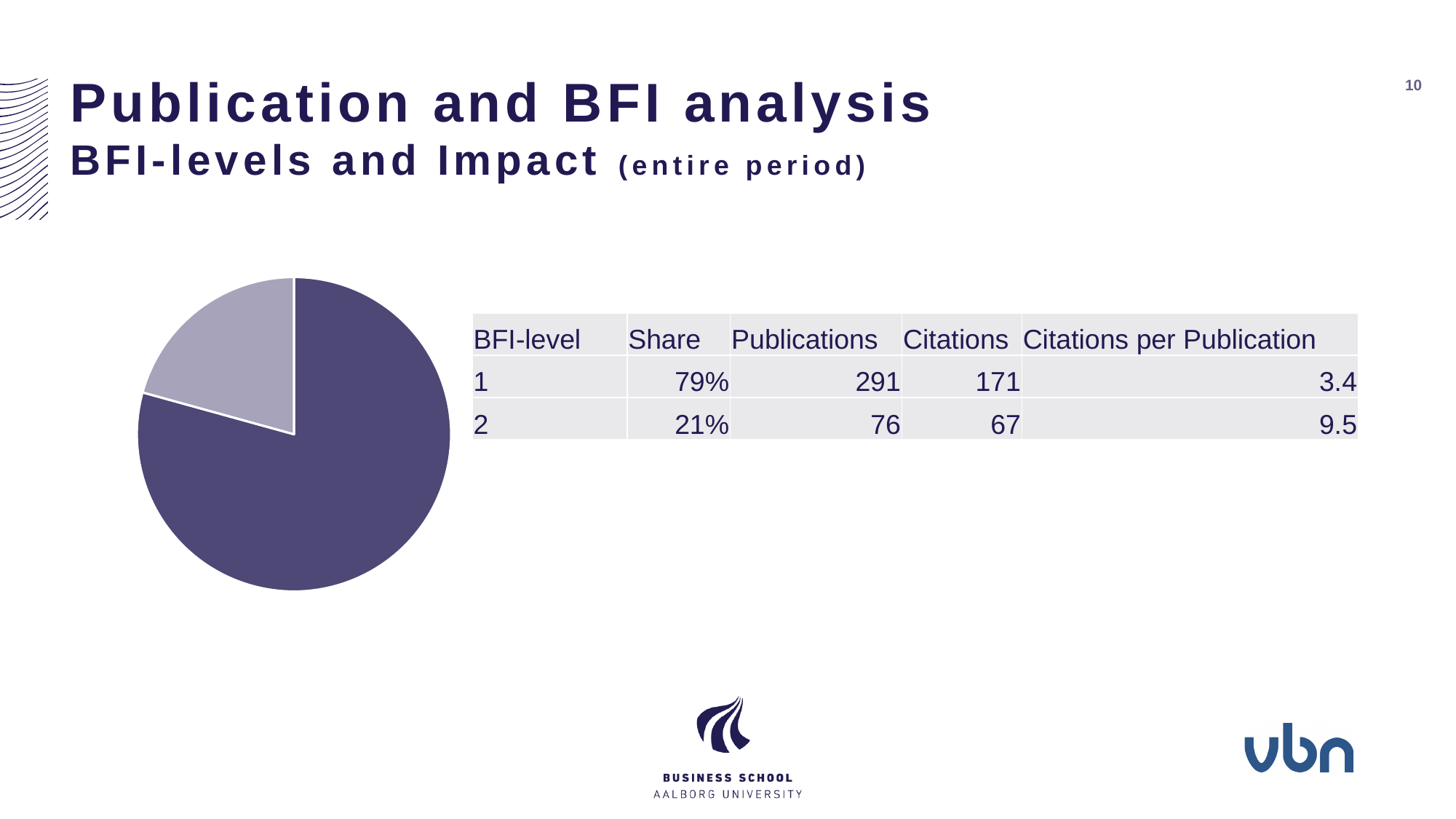
What is the share for BFI-level 2? 21% Which BFI-level has the largest share of the pie? 1 What is the difference in percentage points between the share of BFI-level 1 and BFI-level 2? 58 percentage points What share of the pie does the smaller slice represent? 21% How many slices does the pie chart have? 2 Which slice of the pie chart is larger, the dark purple one or the light grey-purple one? The dark purple one Does the pie chart display a legend? No What kind of chart is shown on the slide? Pie chart Is the larger slice of the pie chart greater or less than 50% of the pie? greater What colour is the larger slice of the pie chart? Dark purple What is the share for BFI-level 1? 79% What share of the pie does the larger slice represent? 79%